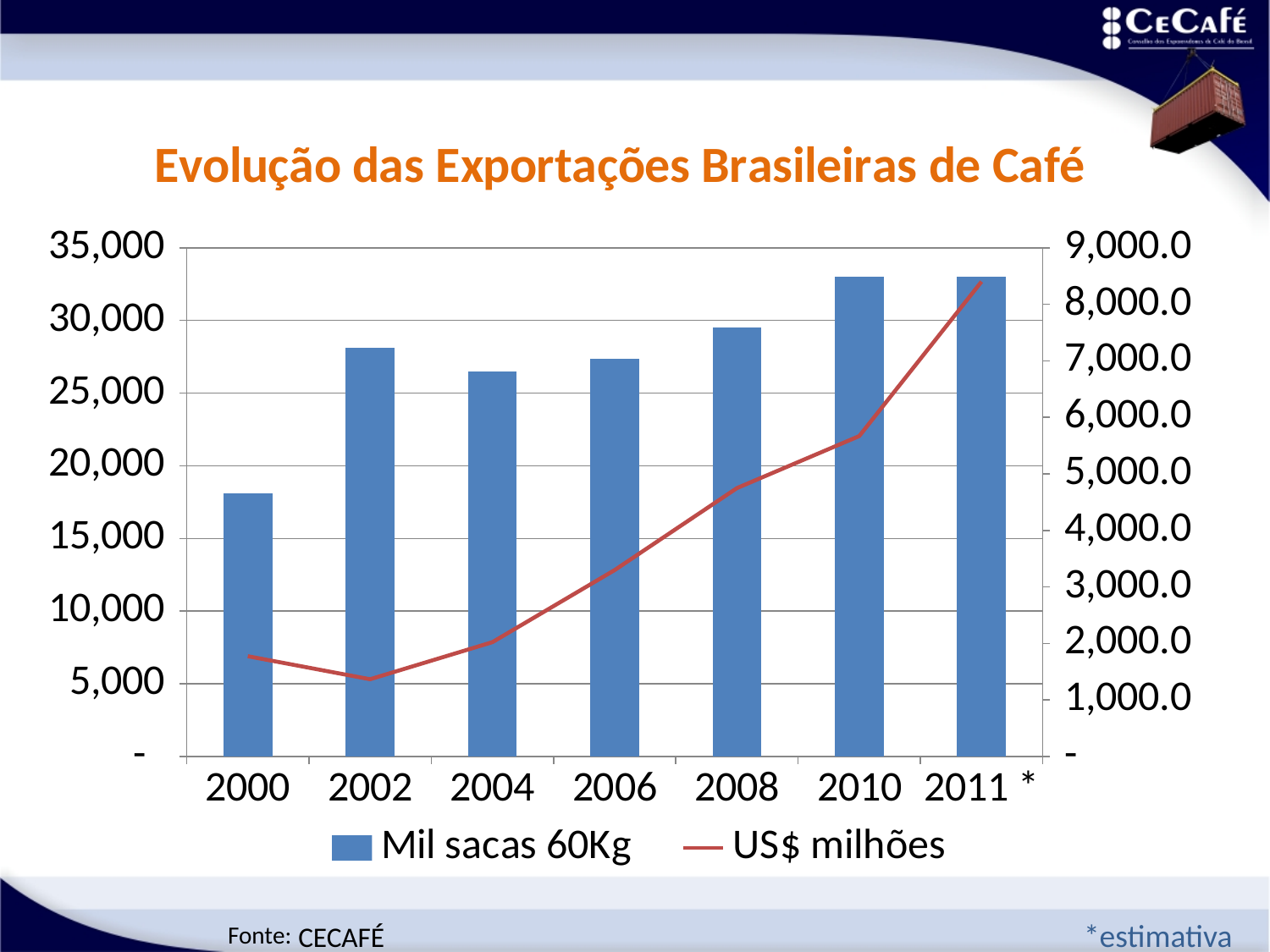
Is the Mil sacas 60Kg value for 2010 greater or less than 30,000? greater Which year has the lowest bar for Mil sacas 60Kg? 2000 In which year is the US$ milhões line at its lowest point? 2002 Does the US$ milhões line generally rise or fall from 2002 to 2011 *? rise Is the US$ milhões value for 2002 greater or less than 2,000.0? less Is the US$ milhões value for 2011 * greater or less than 8,000.0? greater Which year has the larger Mil sacas 60Kg bar, 2002 or 2004? 2002 How many series does the legend list? 2 How many years are shown on the x axis? 7 In which year does the US$ milhões line reach its highest point? 2011 * What kind of chart is shown on the slide? A combined bar and line chart